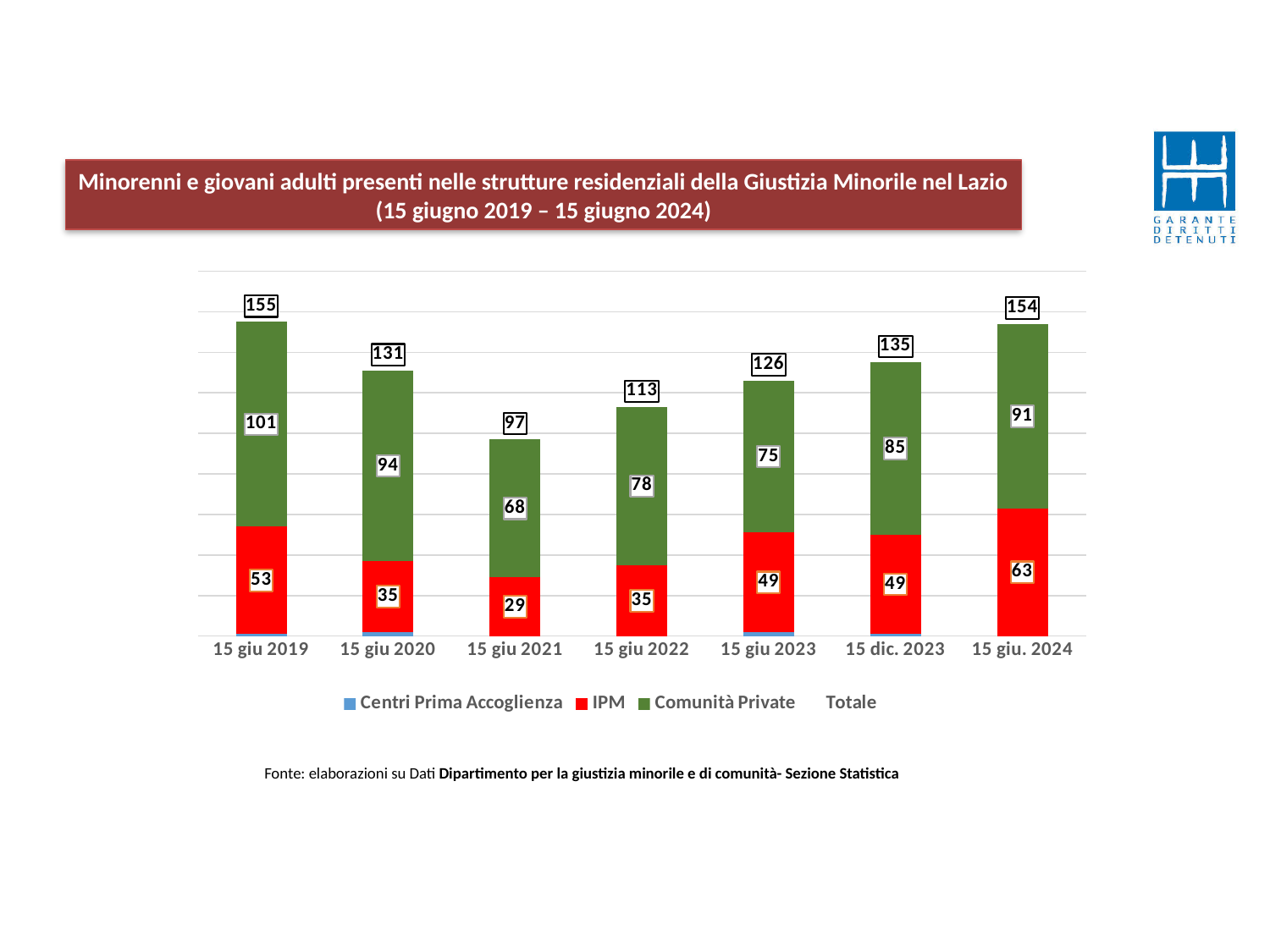
Do the totals rise or fall from 15 giu 2021 to 15 giu. 2024? Rise What kind of chart is shown on the slide? Stacked bar chart How many dates are shown on the x axis? 7 What is the IPM value for 15 giu. 2024? 63 How many entries does the legend list? 4 Which date has the highest Comunità Private value? 15 giu 2019 What is the total value shown for 15 giu 2019? 155 Which colour represents IPM in the chart? Red What is the difference between the total for 15 giu 2019 and the total for 15 giu 2021? 58 Which date has the lowest total? 15 giu 2021 What is the Comunità Private value for 15 giu 2021? 68 Which is larger: the IPM value for 15 giu 2020 or the IPM value for 15 giu 2023? 15 giu 2023